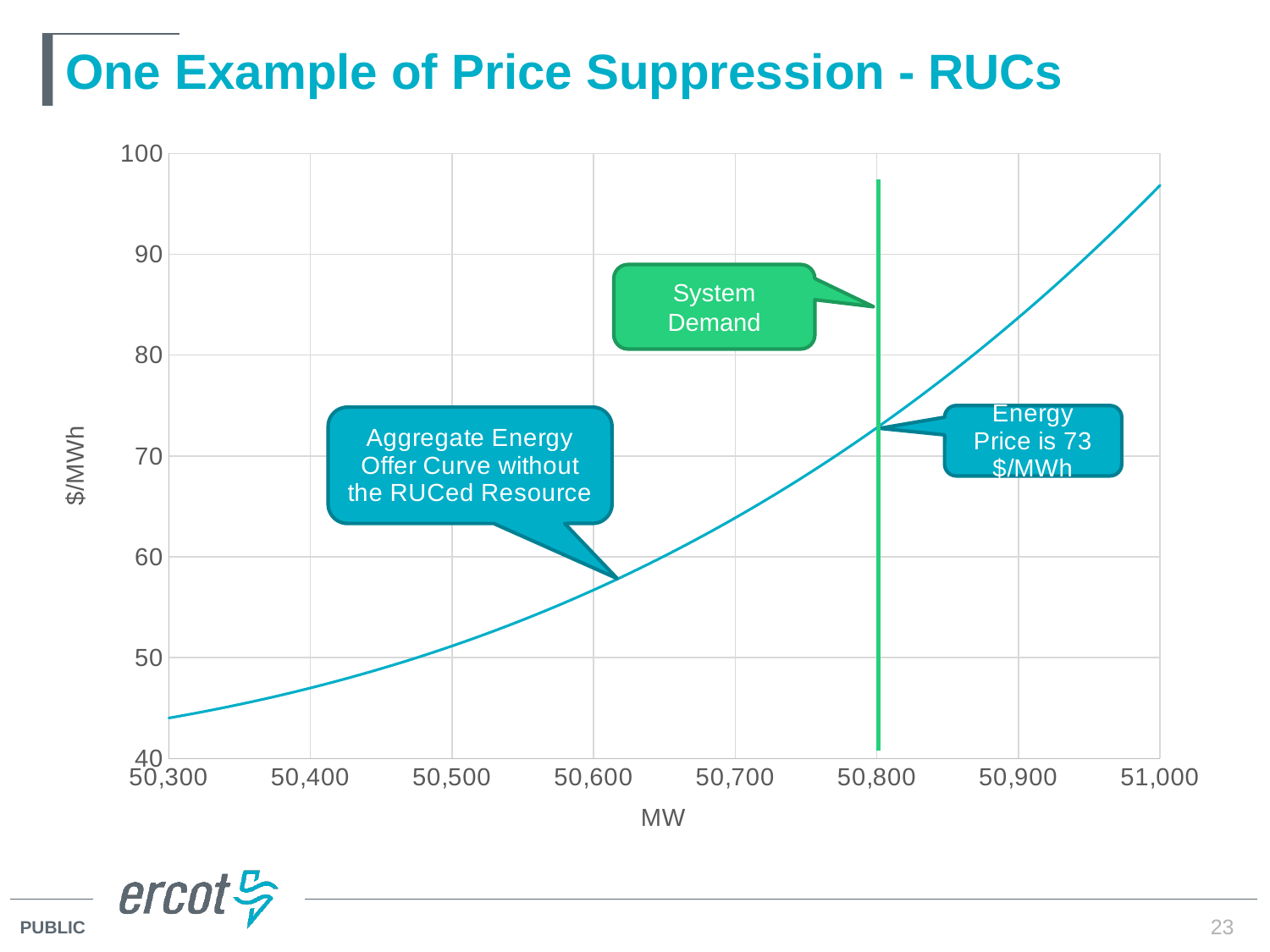
Does the Aggregate Energy Offer Curve rise or fall as MW increases along the x axis? rise What kind of chart is shown on the slide? line chart What is the label of the x axis? MW Is the offer curve value at 50,700 MW larger or smaller than its value at 50,500 MW? larger According to the annotation, what is the energy price where the offer curve meets the System Demand line? 73 $/MWh At what MW level is the System Demand vertical line drawn? 50,800 Is the value of the offer curve at 50,300 MW greater or less than 50 $/MWh? less Is the value of the offer curve at 50,600 MW greater or less than 60 $/MWh? less Is the value of the offer curve at 51,000 MW greater or less than 90 $/MWh? greater What does the blue callout say the curve represents? Aggregate Energy Offer Curve without the RUCed Resource